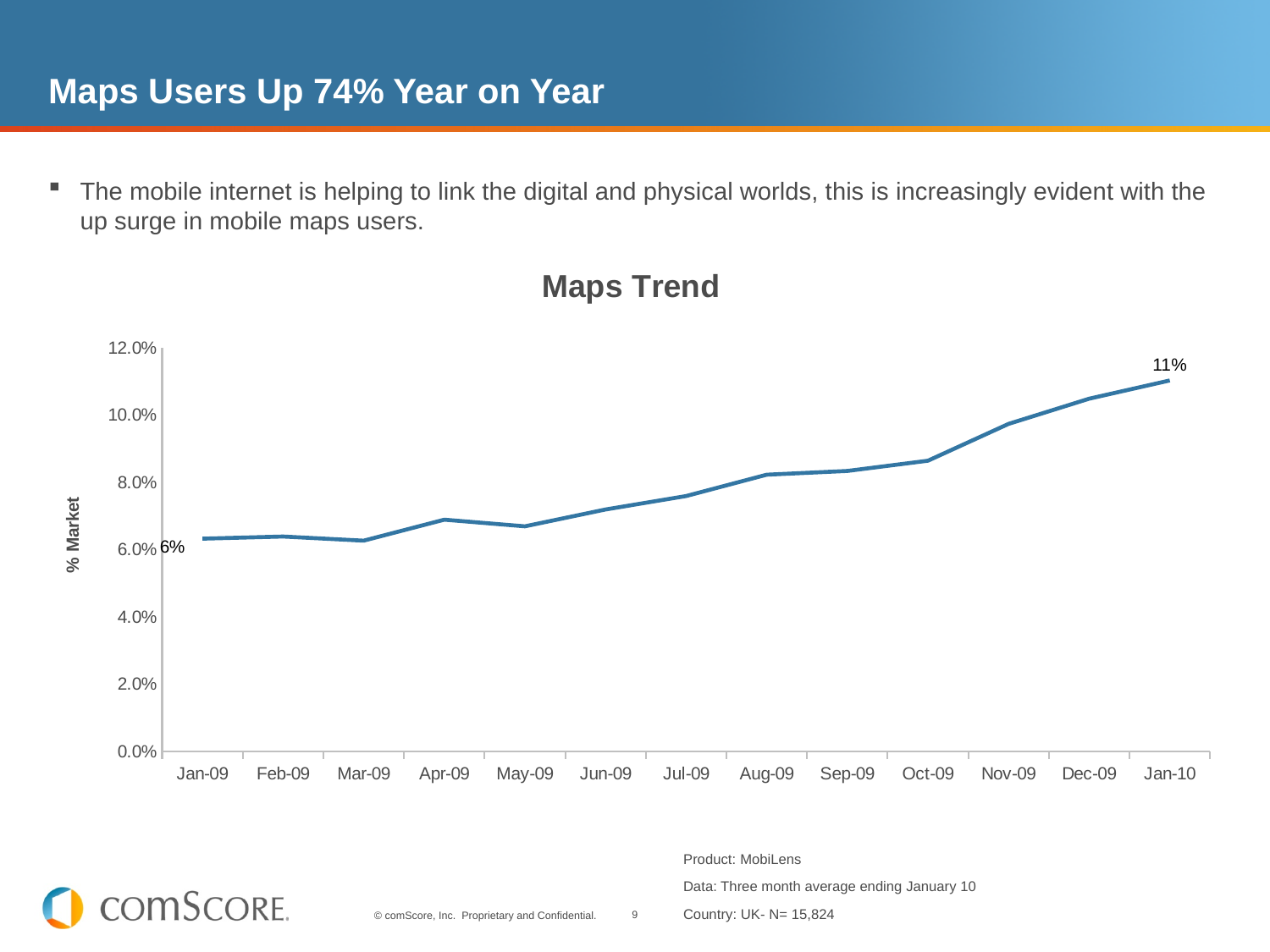
Is the value for Dec-09 greater or less than 10.0%? greater What is the label on the y axis of the Maps Trend chart? % Market Do the values in the Maps Trend chart generally rise or fall from Jan-09 to Jan-10? Rise How many months are plotted on the x axis of the Maps Trend chart? 13 Is the value for Jun-09 greater or less than 8.0%? less What is the value for Jan-09 in the Maps Trend chart? 6% Is the value for Oct-09 greater or less than 8.0%? greater What is the difference between the Jan-10 and Jan-09 values in the Maps Trend chart? 5 percentage points Which month has the highest value in the Maps Trend chart? Jan-10 What is the value for Jan-10 in the Maps Trend chart? 11% Which is larger in the Maps Trend chart, the value for Jan-09 or Jan-10? Jan-10 What kind of chart is the Maps Trend chart? Line chart